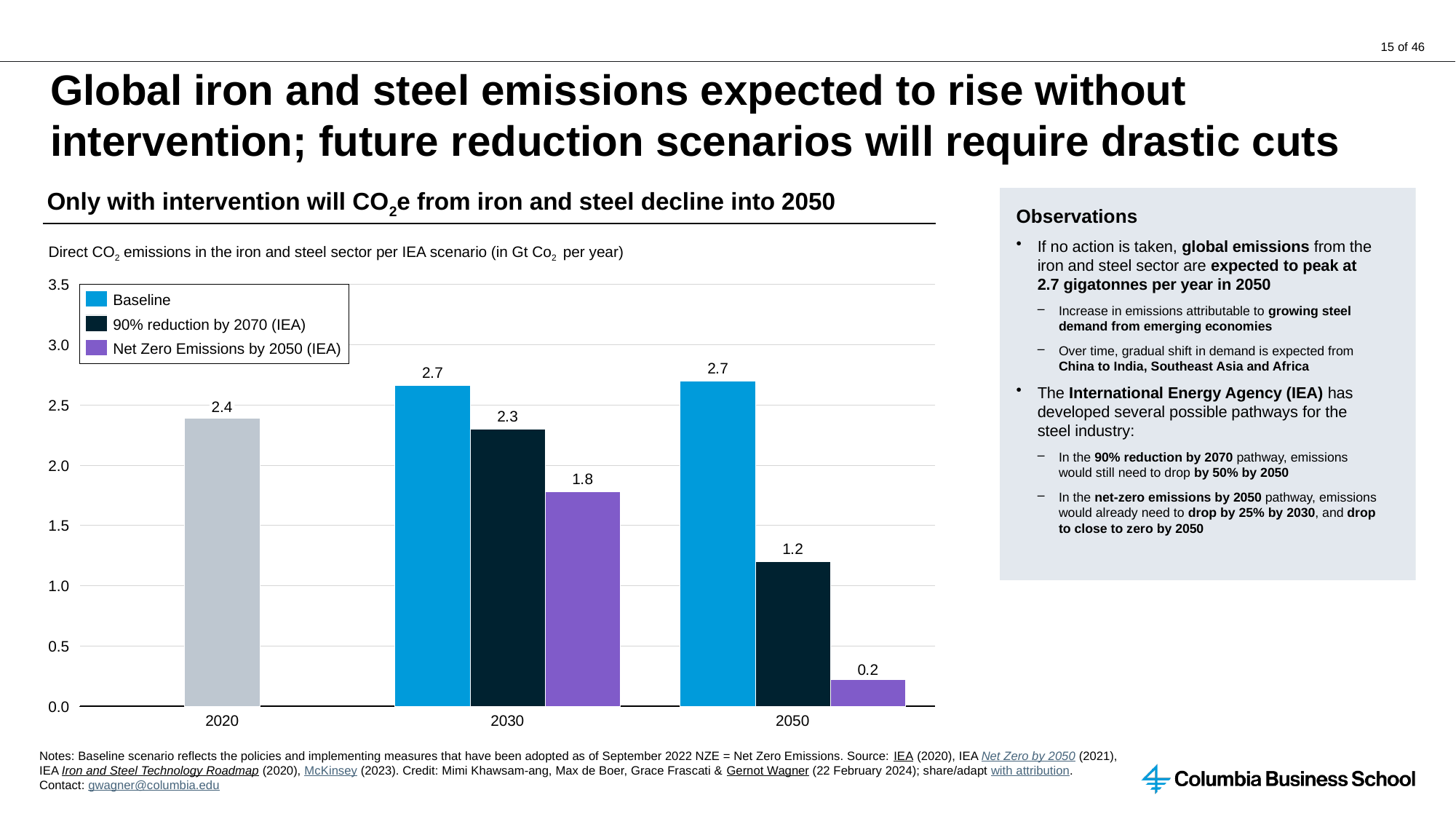
What is the difference between the Baseline and the 90% reduction by 2070 (IEA) values in 2050? 1.5 Which scenario has the lowest value in 2050? Net Zero Emissions by 2050 (IEA) What is the value shown for 2020? 2.4 Which is larger in 2030: the Baseline value or the Net Zero Emissions by 2050 (IEA) value? Baseline What is the value for the Net Zero Emissions by 2050 (IEA) scenario in 2030? 1.8 How many years are shown on the x axis? 3 What kind of chart is shown on the slide? Bar chart What is the value for the 90% reduction by 2070 (IEA) scenario in 2050? 1.2 Do the values for the Net Zero Emissions by 2050 (IEA) scenario rise or fall from 2030 to 2050? Fall How many series does the legend list? 3 What is the Baseline value for 2050? 2.7 What is the difference between the 90% reduction by 2070 (IEA) value in 2030 and in 2050? 1.1